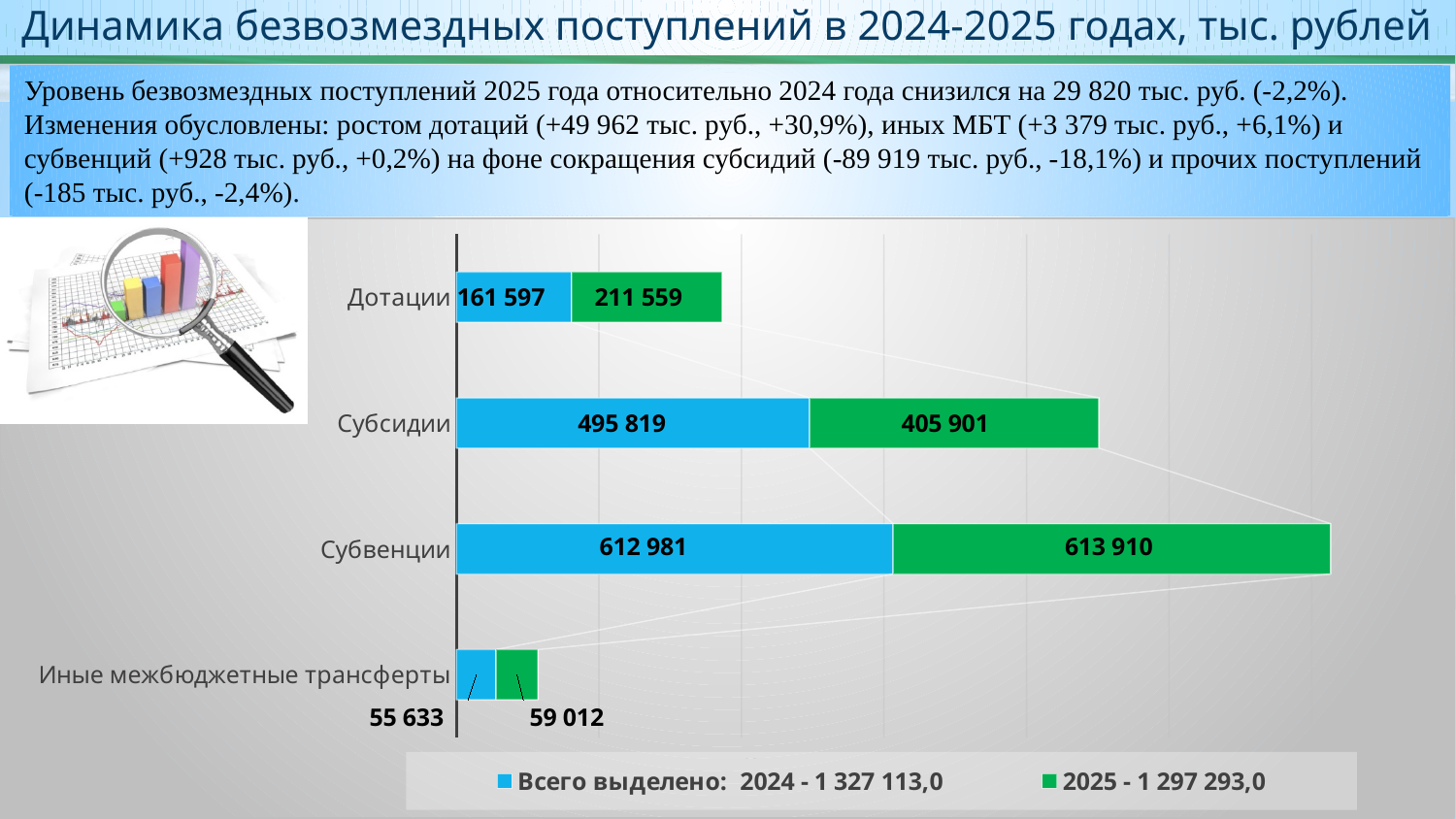
What is the 2024 value for Субвенции? 612 981 What kind of chart is shown on the slide? Stacked bar chart What is the 2025 value for Иные межбюджетные трансферты? 59 012 Which is larger for Дотации: the 2024 value or the 2025 value? 2025 What is the total of the stacked bar for Иные межбюджетные трансферты? 114 645 What is the 2025 value for Дотации? 211 559 How many series does the legend list? 2 Which category has the highest 2024 value? Субвенции What is the difference between the 2024 and 2025 values for Субсидии? 89 918 How many categories are shown on the chart? 4 Which category has the lowest 2025 value? Иные межбюджетные трансферты What is the 2024 value for Субсидии? 495 819